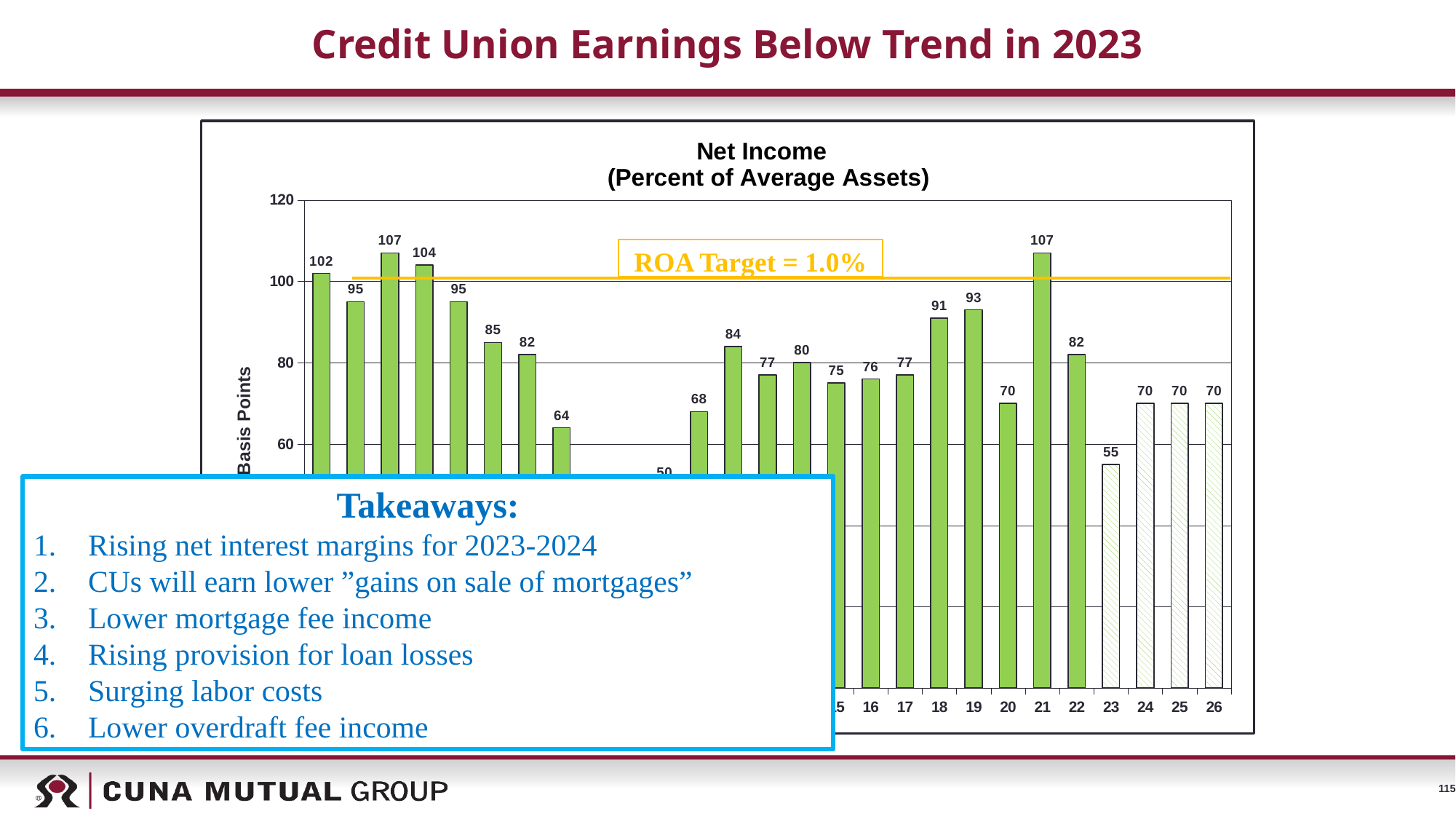
Do the net income values rise, fall, or stay flat from year 24 to year 26? stay flat What is the net income value for year 18? 91 What is the net income value (in basis points) for year 21? 107 Among the years labeled 16 through 26, which year has the lowest net income? 23 What is the net income value for year 23? 55 Which year has the larger net income value, 18 or 19? 19 What ROA target is marked by the horizontal line on the chart? 1.0% What is the net income value for year 22? 82 Is the net income value for year 23 greater or less than 60? less Among the years labeled 16 through 26, which year has the highest net income? 21 What kind of chart is used to show Net Income (Percent of Average Assets)? bar chart What is the difference between the net income values for year 21 and year 22? 25